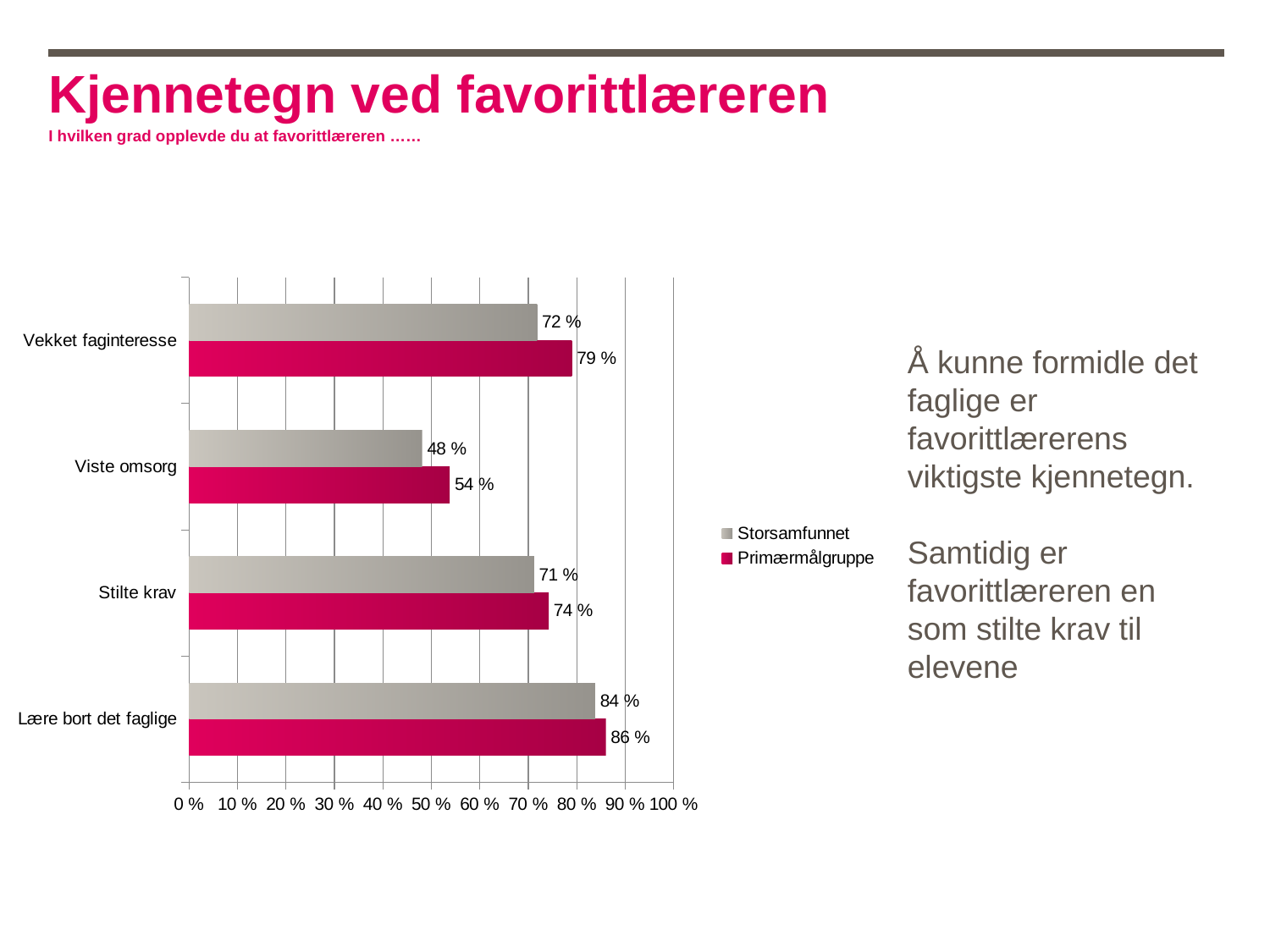
What is the value for Primærmålgruppe in the Vekket faginteresse category? 79 % What is the value for Storsamfunnet in the Lære bort det faglige category? 84 % What is the difference between the Primærmålgruppe and Storsamfunnet values for Vekket faginteresse? 7 % What is the value for Storsamfunnet in the Viste omsorg category? 48 % What kind of chart is shown on the slide? Bar chart How many series does the legend list? 2 Which is larger for Stilte krav: the Storsamfunnet value or the Primærmålgruppe value? Primærmålgruppe Which category has the lowest value for Storsamfunnet? Viste omsorg What is the difference between the Primærmålgruppe and Storsamfunnet values for Viste omsorg? 6 % How many categories are shown on the chart? 4 Which series is shown in magenta/pink? Primærmålgruppe Which category has the highest value for Primærmålgruppe? Lære bort det faglige